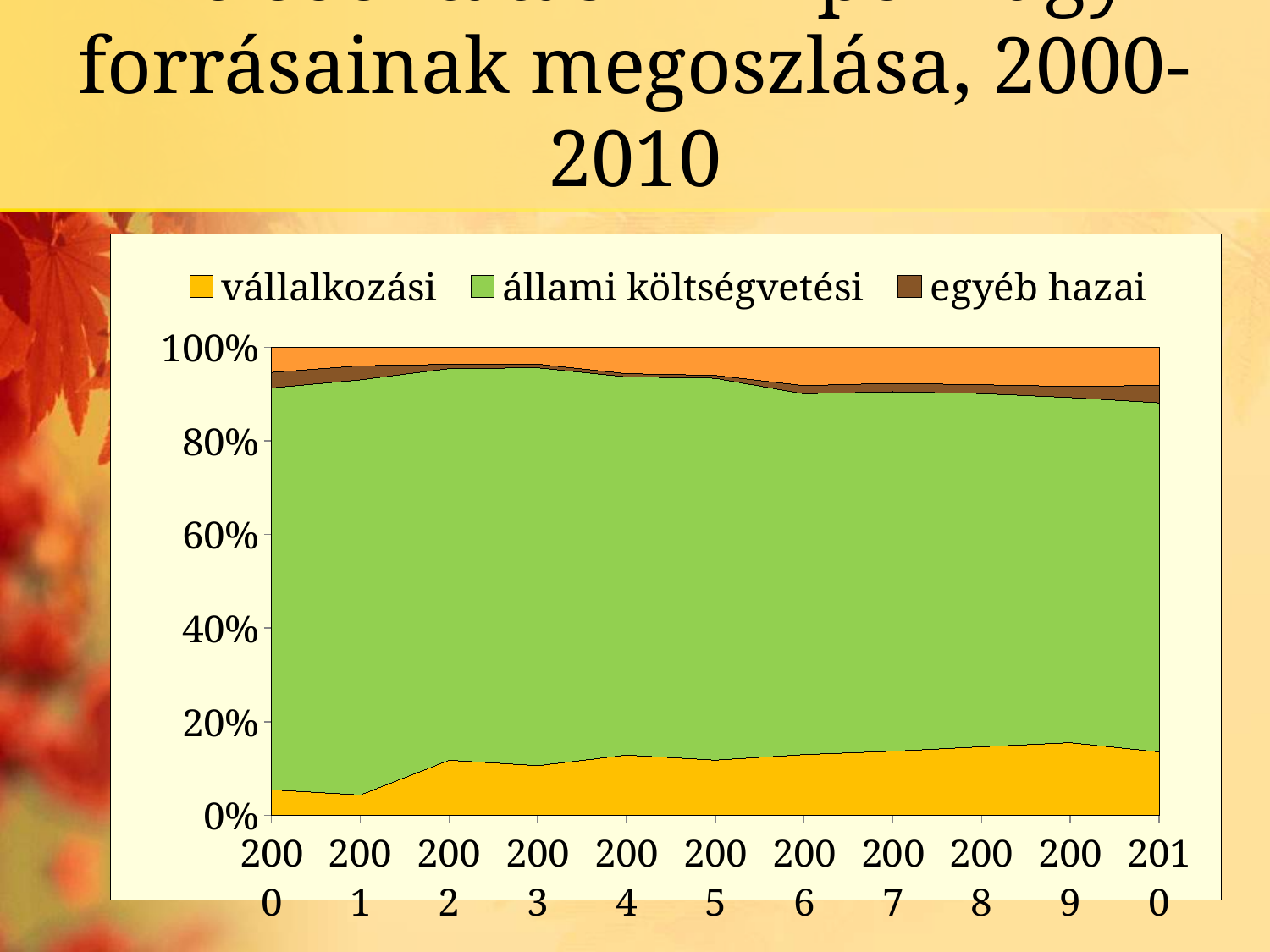
Which years does the x axis cover? 2000 to 2010 Which colour represents the 'állami költségvetési' series? green What kind of chart is shown on the slide? area chart How many years are shown along the x axis? 11 Is the 'vállalkozási' share larger in 2001 or in 2002? 2002 Is the share of 'vállalkozási' in 2000 greater or less than 20%? less Is the 'vállalkozási' share larger in 2000 or in 2010? 2010 Is the cumulative top of the 'állami költségvetési' area in 2000 greater or less than 80%? greater Which series occupies the largest share in every year? állami költségvetési How many series does the legend list? 3 Is the share of 'vállalkozási' in 2010 greater or less than 20%? less Does the 'vállalkozási' share generally rise or fall from 2000 to 2010? rise